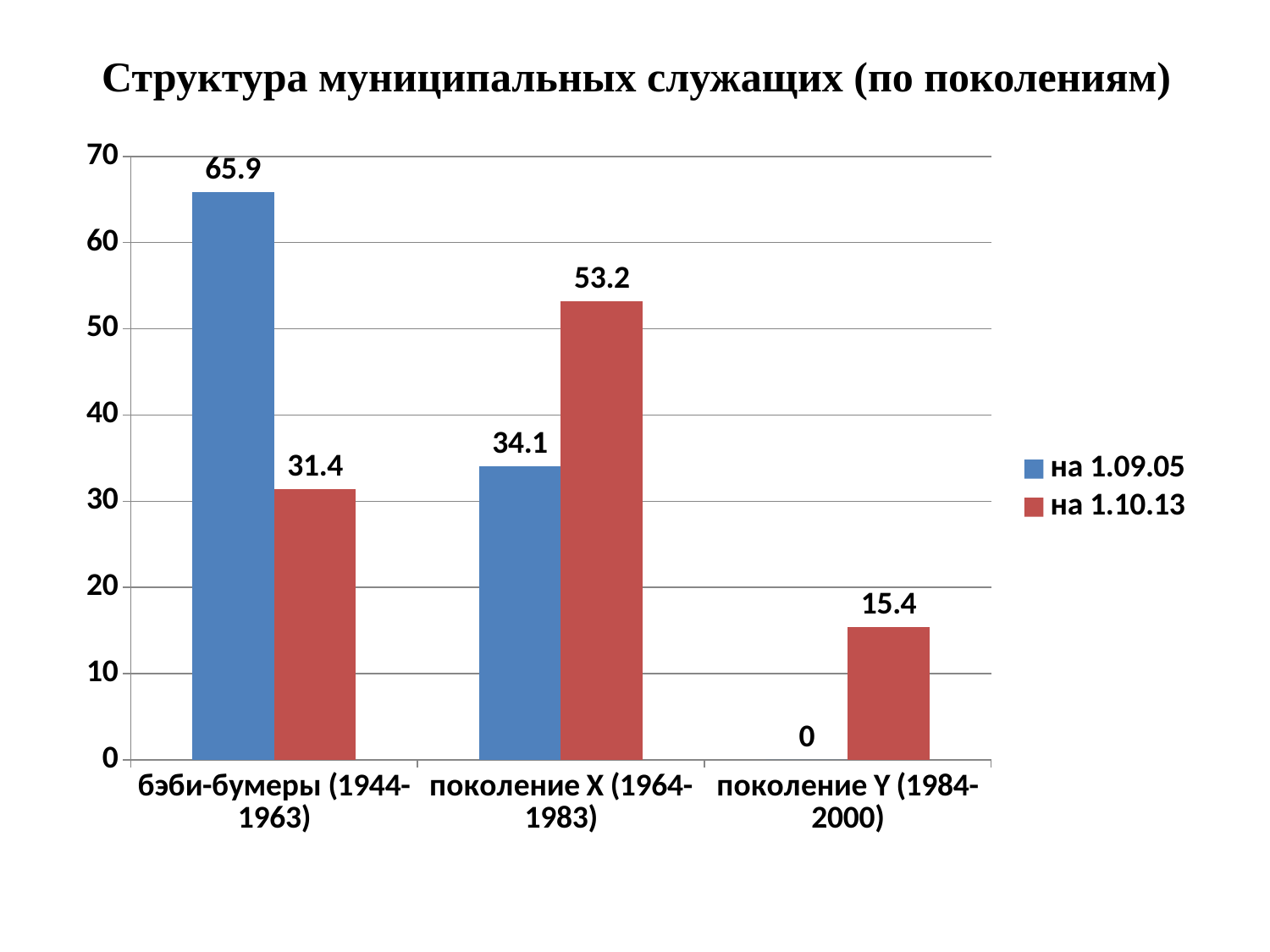
Which category has the highest value in the series на 1.10.13? поколение X (1964-1983) For поколение X (1964-1983), which series has the larger value: на 1.09.05 or на 1.10.13? на 1.10.13 What is the value for бэби-бумеры (1944-1963) in the series на 1.09.05? 65.9 How many categories are shown on the x axis? 3 What kind of chart is shown on the slide? bar chart What is the value for поколение Y (1984-2000) in the series на 1.09.05? 0 Which category has the lowest value in the series на 1.09.05? поколение Y (1984-2000) What is the value for поколение Y (1984-2000) in the series на 1.10.13? 15.4 What is the value for поколение X (1964-1983) in the series на 1.10.13? 53.2 How many series does the legend list? 2 What is the difference between the на 1.09.05 and на 1.10.13 values for бэби-бумеры (1944-1963)? 34.5 Is the value for бэби-бумеры (1944-1963) in the series на 1.10.13 greater or less than 40? less